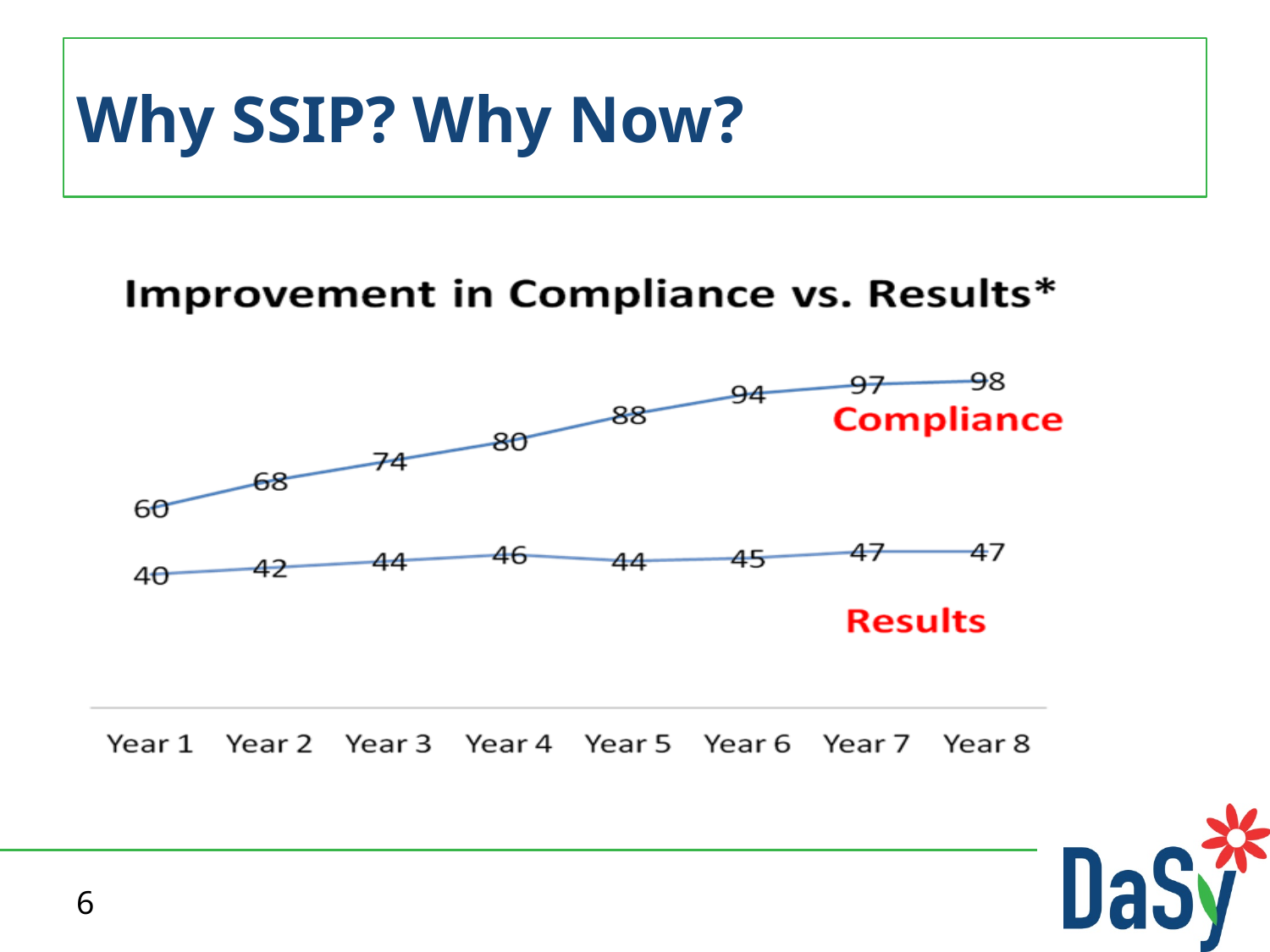
What is the difference between the Compliance and Results values in Year 8? 51 How many years are shown on the x axis? 8 What type of chart is shown? Line chart In which year is the Compliance value highest? Year 8 What is the Results value in Year 8? 47 What is the Compliance value in Year 1? 60 What is the Compliance value in Year 5? 88 Which is larger in Year 3, the Compliance value or the Results value? Compliance By how much did the Compliance value increase from Year 1 to Year 8? 38 What is the title of the chart? Improvement in Compliance vs. Results* What is the Results value in Year 4? 46 In which year is the Results value lowest? Year 1